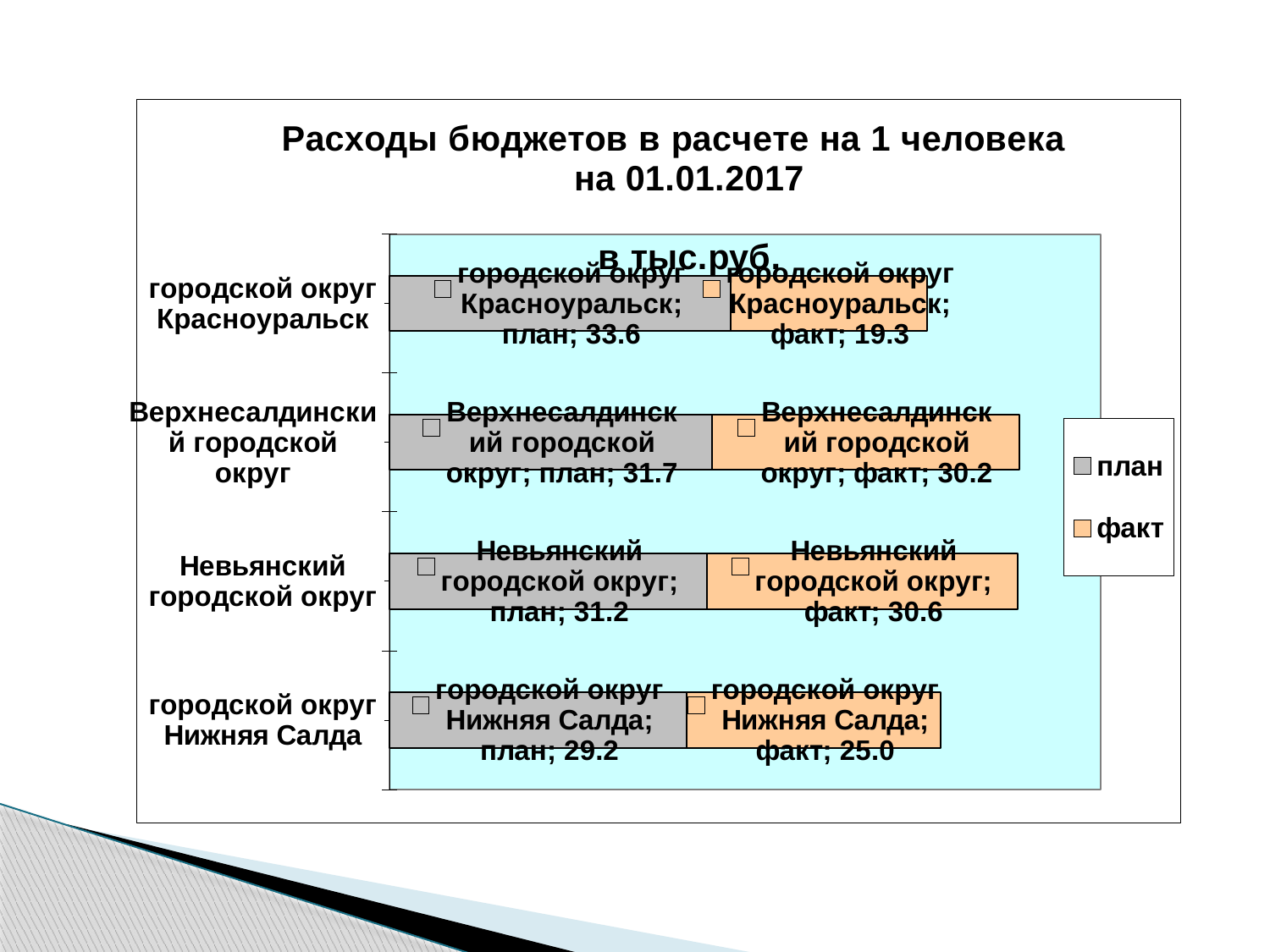
What is the difference between план and факт for городской округ Нижняя Салда? 4.2 How many series does the legend list? 2 What kind of chart is shown on the slide? bar chart What is the факт value for Невьянский городской округ? 30.6 What is the факт value for городской округ Нижняя Салда? 25.0 Which category has the lowest факт value? городской округ Красноуральск What is the план value for Верхнесалдинский городской округ? 31.7 How many categories (municipalities) are shown in the chart? 4 Which is larger for Невьянский городской округ, план or факт? план What is the difference between план and факт for городской округ Красноуральск? 14.3 Which category has the highest план value? городской округ Красноуральск What is the план value for городской округ Красноуральск? 33.6